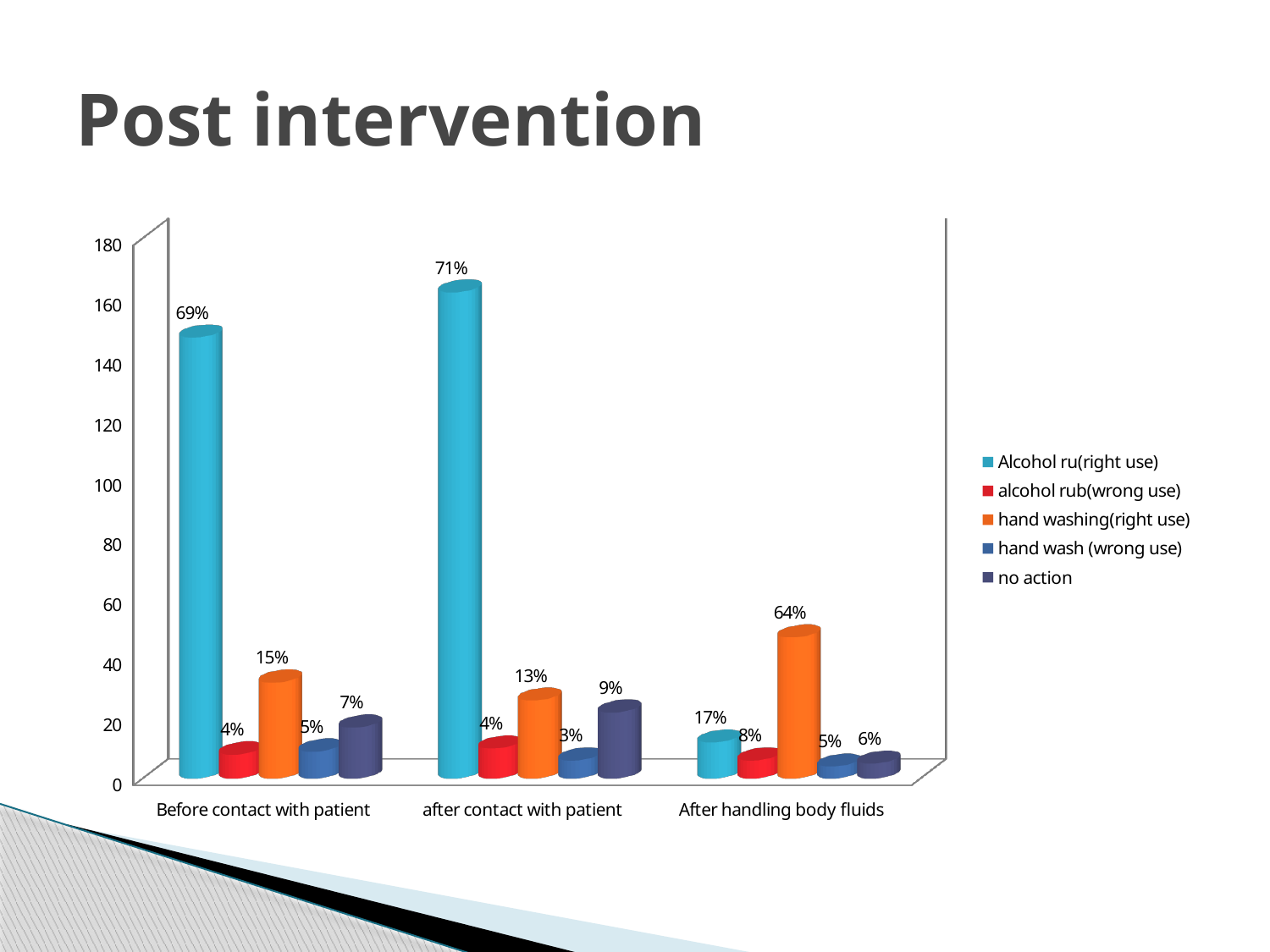
How many categories are shown on the x axis? 3 What is the difference between the Alcohol ru(right use) labels for after contact with patient (71%) and Before contact with patient (69%)? 2% What is the data label for hand wash (wrong use) in the after contact with patient category? 3% What kind of chart is shown on the slide? bar chart What is the data label for no action in the after contact with patient category? 9% How many series does the legend list? 5 Is the Alcohol ru(right use) bar for after contact with patient greater or less than 140 on the vertical axis? greater What is the data label for Alcohol ru(right use) in the Before contact with patient category? 69% Which is larger in the Before contact with patient category: hand washing(right use) or no action? hand washing(right use) What is the data label for hand washing(right use) in the After handling body fluids category? 64% Which category has the highest value for Alcohol ru(right use)? after contact with patient Which series has the lowest value in the After handling body fluids category? hand wash (wrong use)